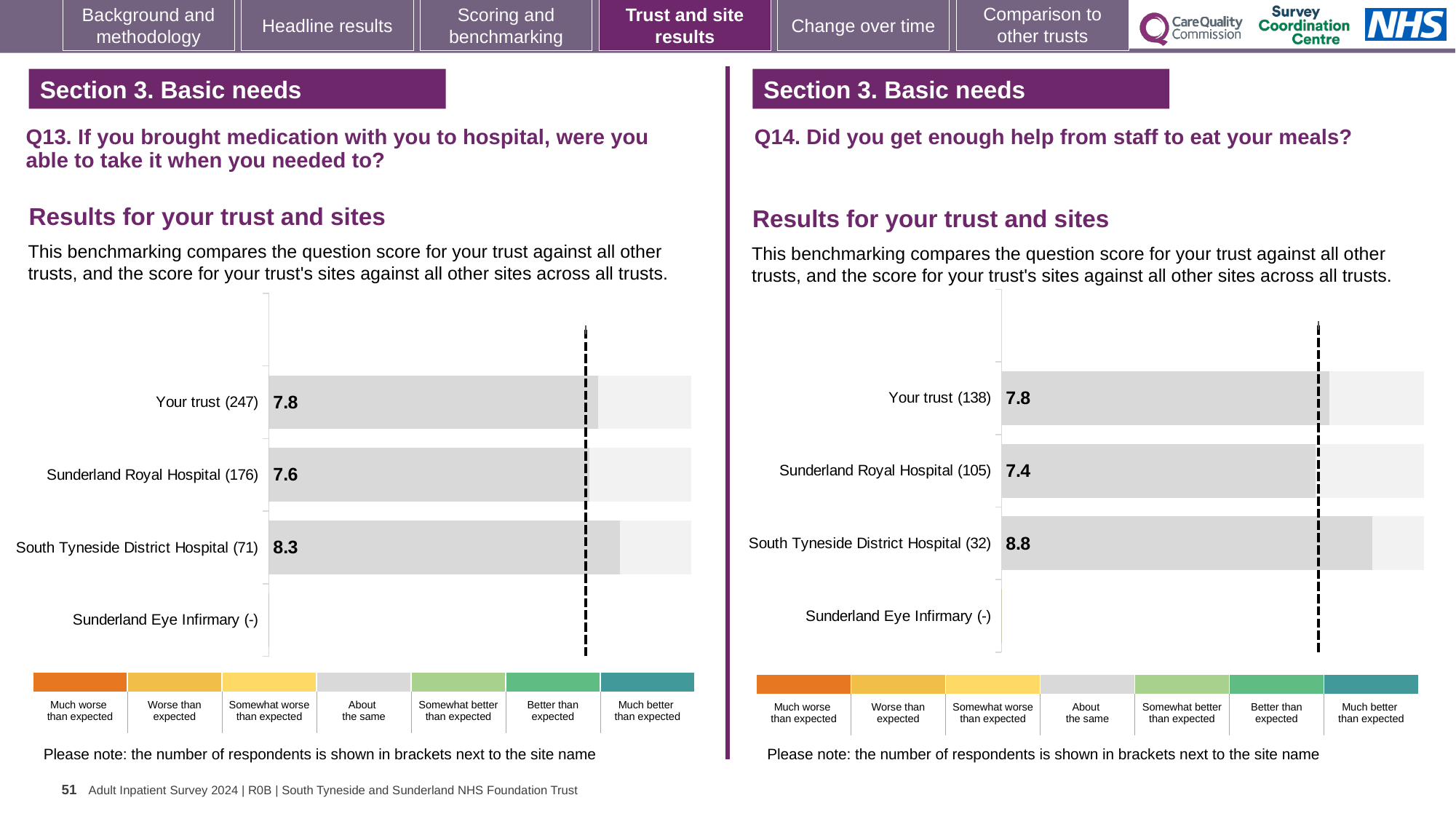
On the Q14 chart, what is the score for Sunderland Royal Hospital? 7.4 On the Q13 chart, what is the score for South Tyneside District Hospital? 8.3 On the Q14 chart, what is the difference between the scores for South Tyneside District Hospital and Sunderland Royal Hospital? 1.4 What kind of chart is used for the Q13 results? Bar chart On the Q13 chart, which has the larger score, Your trust or Sunderland Royal Hospital? Your trust On the Q13 chart, what is the score for Your trust? 7.8 On the Q13 chart, which site has the highest score? South Tyneside District Hospital How many sites or rows are listed on the Q14 chart? 4 On the Q14 chart, what is the score for South Tyneside District Hospital? 8.8 On the Q14 chart, which site has the lowest score shown? Sunderland Royal Hospital On the Q13 chart, what is the difference between the scores for South Tyneside District Hospital and Sunderland Royal Hospital? 0.7 On the Q13 chart, how many respondents are shown in brackets for Your trust? 247